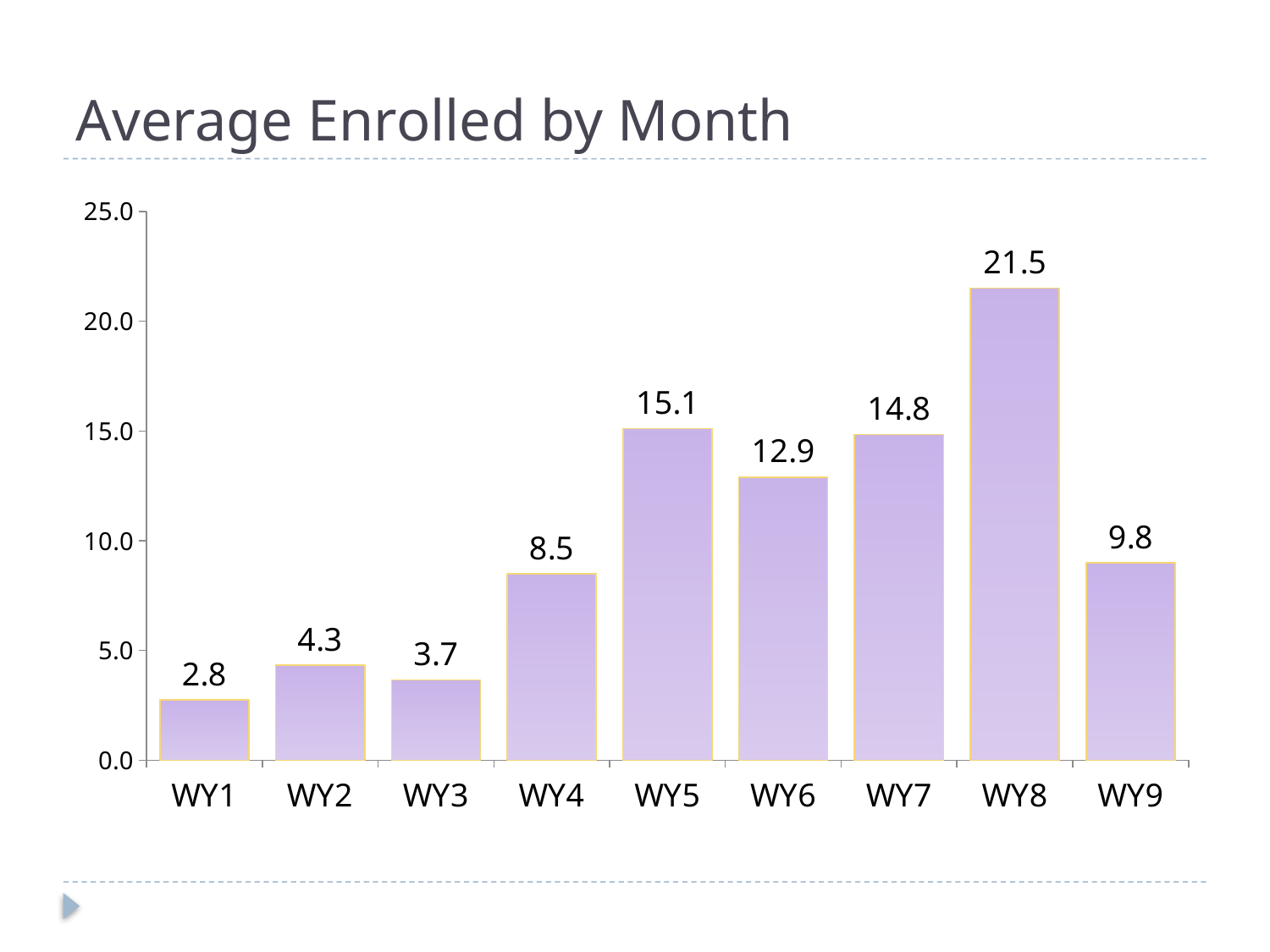
Which category has the lowest average enrolled value? WY1 How many categories are shown on the x axis? 9 What is the difference between the values for WY4 and WY3? 4.8 What is the title of the chart? Average Enrolled by Month What is the average enrolled value for WY5? 15.1 What is the average enrolled value for WY1? 2.8 Which is larger, the value for WY6 or the value for WY9? WY6 What is the average enrolled value for WY9? 9.8 Is the value for WY8 greater or less than 20.0? greater Which category has the highest average enrolled value? WY8 What kind of chart is shown on the slide? bar chart What is the difference between the values for WY8 and WY7? 6.7